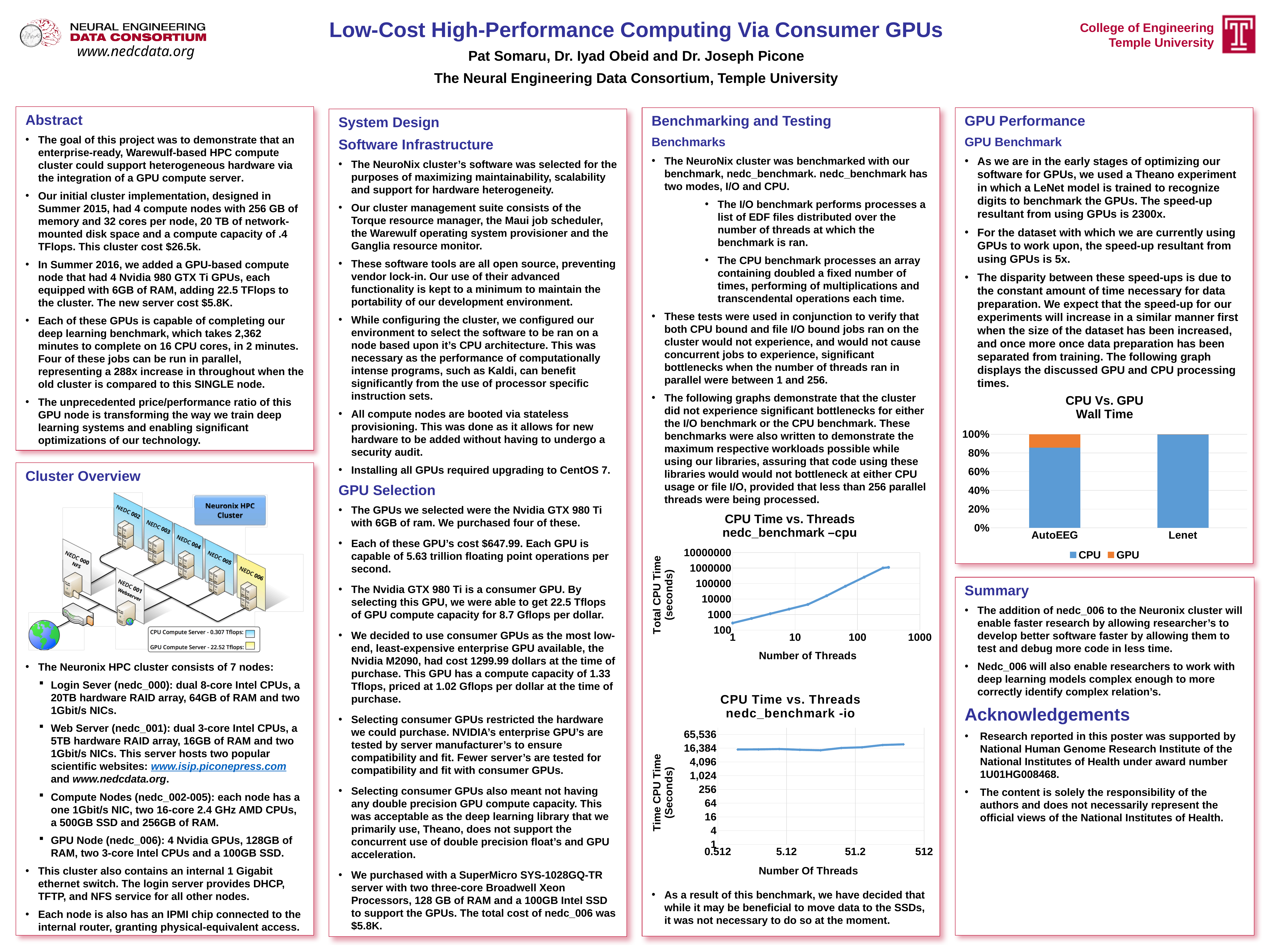
In the 'CPU Vs. GPU Wall Time' chart, what are the two series named in the legend? CPU and GPU In the 'CPU Vs. GPU Wall Time' chart, is the GPU share for AutoEEG greater or less than 20%? less In the 'CPU Vs. GPU Wall Time' chart, how many categories are shown on the x axis? 2 In the 'CPU Time vs. Threads nedc_benchmark -io' chart, is the CPU time at the highest number of threads greater or less than 4,096 seconds? greater In the 'CPU Vs. GPU Wall Time' chart, how many series does the legend list? 2 What kind of chart is the 'CPU Time vs. Threads nedc_benchmark –cpu' chart? Line chart In the 'CPU Vs. GPU Wall Time' chart, which category has the larger GPU share, AutoEEG or Lenet? AutoEEG In the 'CPU Time vs. Threads nedc_benchmark –cpu' chart, does total CPU time rise or fall as the number of threads increases? Rises In the 'CPU Vs. GPU Wall Time' chart, is the CPU share for Lenet greater or less than 80%? greater What is the x-axis label of the 'CPU Time vs. Threads nedc_benchmark -io' chart? Number Of Threads What kind of chart is the 'CPU Vs. GPU Wall Time' chart? Stacked bar chart